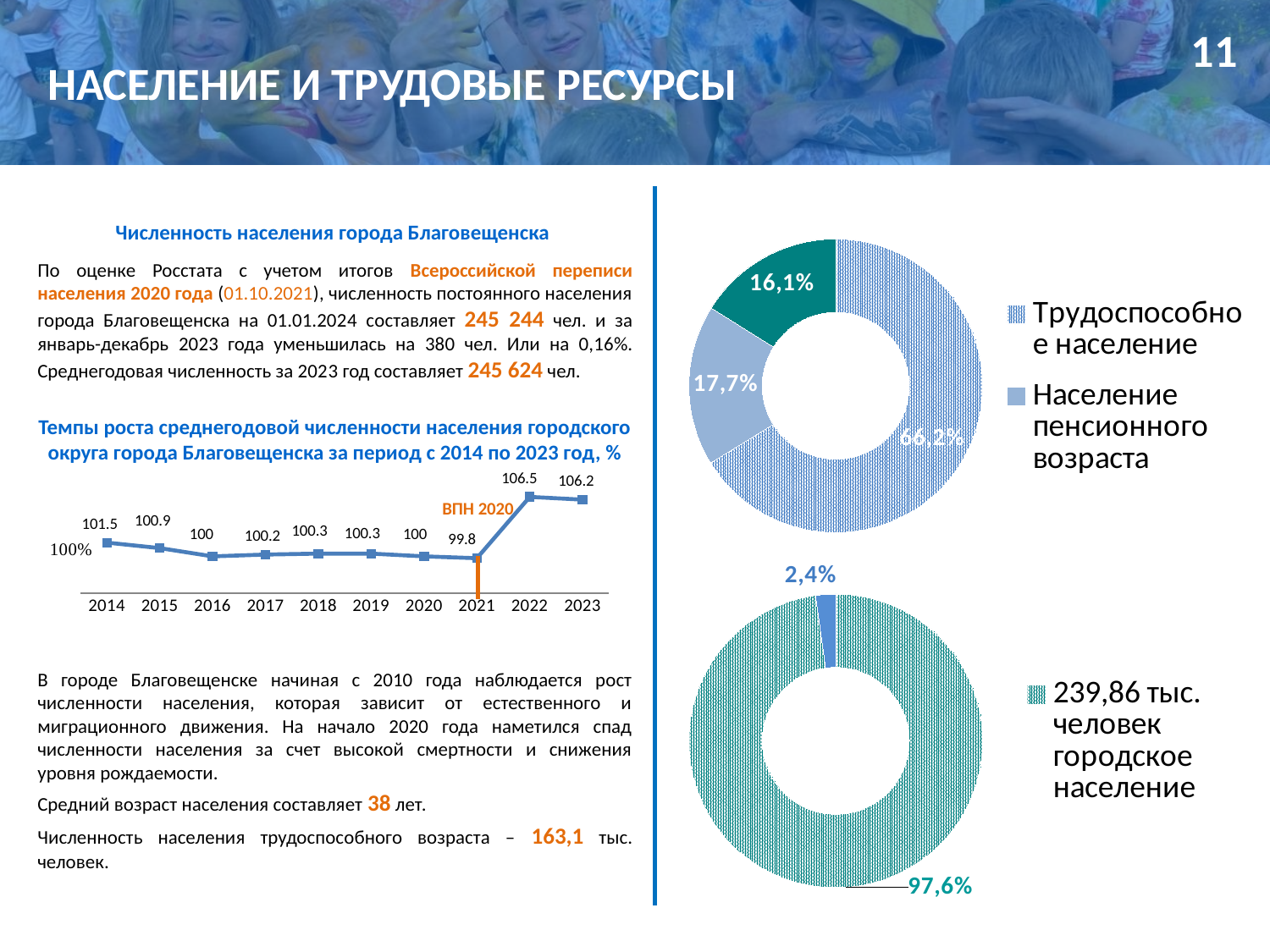
On the upper donut chart on the right, what share is shown for 'Население пенсионного возраста'? 17,7% On the line chart 'Темпы роста среднегодовой численности населения', which year has the highest value? 2022 On the upper donut chart on the right, what share is shown for 'Трудоспособное население'? 66,2% On the line chart 'Темпы роста среднегодовой численности населения', what is the value for 2021? 99.8 On the line chart 'Темпы роста среднегодовой численности населения', is the value for 2023 larger or smaller than the value for 2015? larger On the line chart 'Темпы роста среднегодовой численности населения', what is the value for 2022? 106.5 On the line chart 'Темпы роста среднегодовой численности населения', what is the value for 2014? 101.5 On the line chart 'Темпы роста среднегодовой численности населения', which year has the lowest value? 2021 On the line chart 'Темпы роста среднегодовой численности населения', what is the difference between the values for 2022 and 2021? 6.7 What type of chart is used for 'Темпы роста среднегодовой численности населения'? line chart On the line chart 'Темпы роста среднегодовой численности населения', how many years are plotted on the x axis? 10 On the lower donut chart on the right, what share is shown for '239,86 тыс. человек городское население'? 97,6%